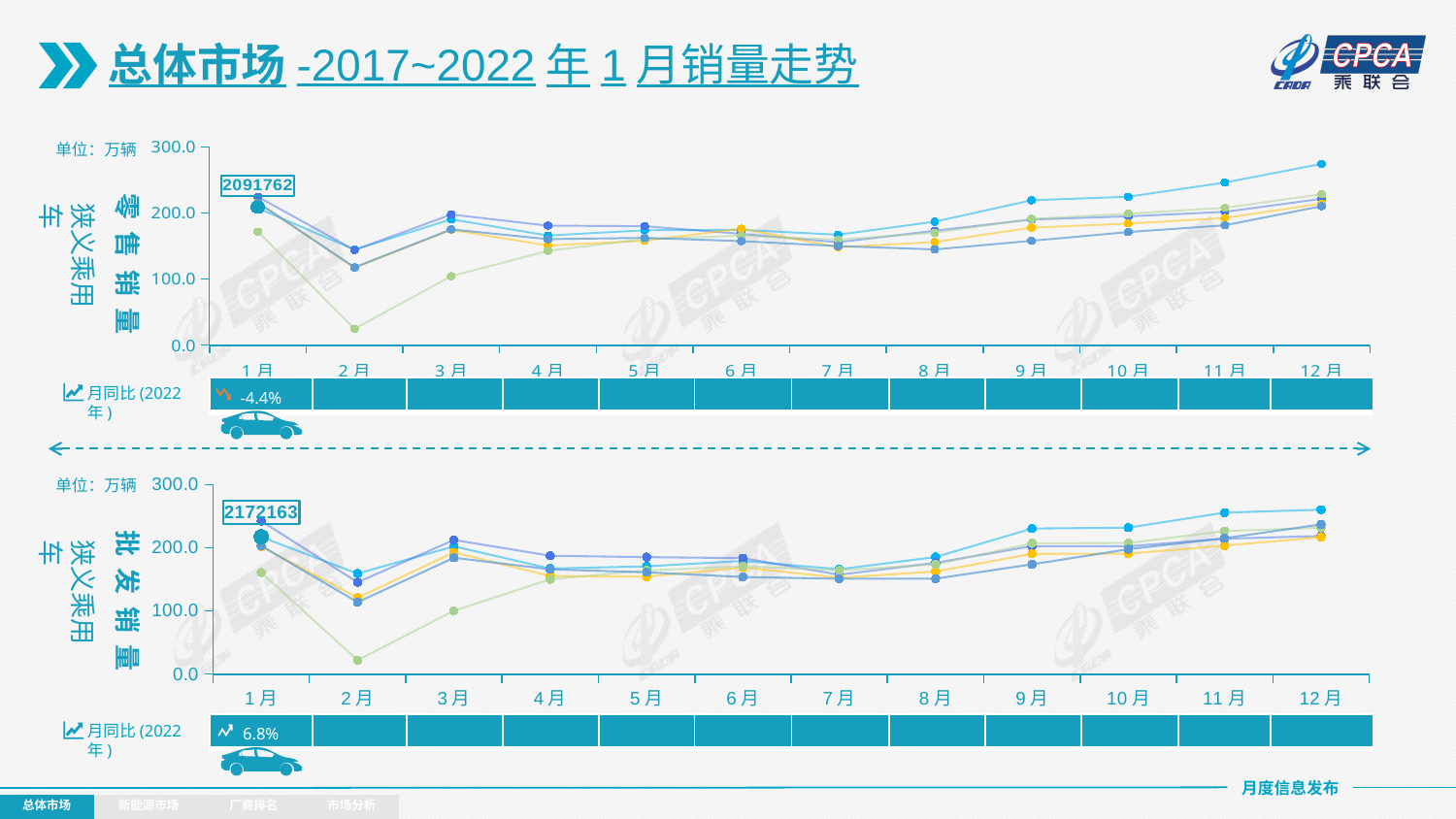
What unit is stated for the values on the charts? 万辆 On the top chart (狭义乘用车零售销量), is the lowest point at 2月 greater or less than 100.0? less How many months are shown on the x axis of the bottom chart (狭义乘用车批发销量)? 12 On the bottom chart (狭义乘用车批发销量), what is the 月同比 (2022年) value shown for 1月? 6.8% On the top chart (狭义乘用车零售销量), is the highest point at 12月 greater or less than 200.0? greater On the bottom chart (狭义乘用车批发销量), is the lowest point at 2月 greater or less than 100.0? less On the top chart (狭义乘用车零售销量), what data label is printed at 1月? 2091762 What is the maximum value shown on the y axis of the top chart? 300.0 On the bottom chart (狭义乘用车批发销量), what data label is printed at 1月? 2172163 What kind of chart is the top chart (狭义乘用车零售销量)? line chart On the bottom chart (狭义乘用车批发销量), do the lines generally rise or fall from 8月 to 12月? rise On the top chart (狭义乘用车零售销量), what is the 月同比 (2022年) value shown for 1月? -4.4%